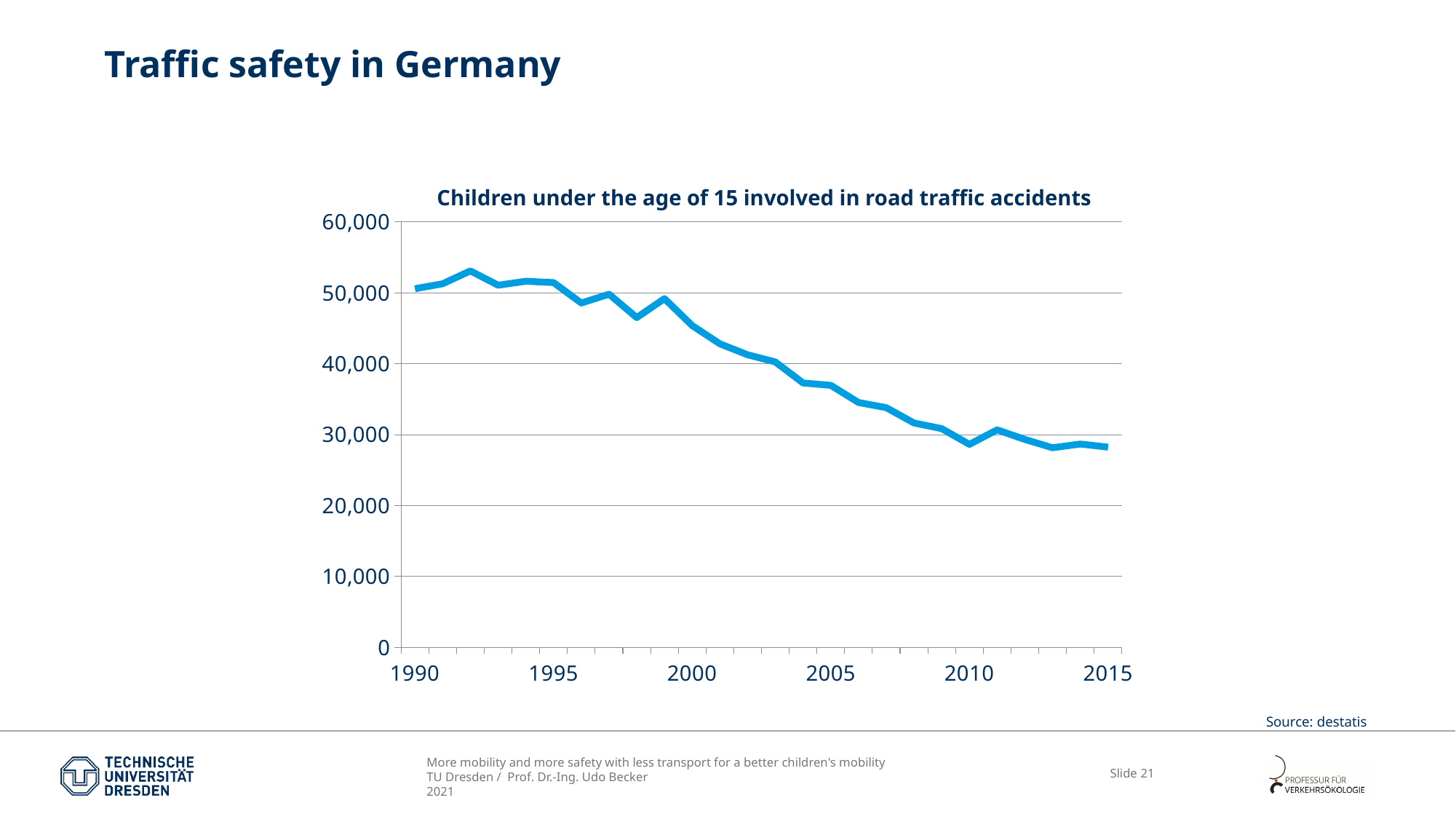
How many years are plotted on the chart, from 1990 to 2015 inclusive? 26 Is the value for 2008 greater or less than 30,000? greater Is the value for 2000 greater or less than 50,000? less Is the value for 2005 greater or less than 40,000? less What source is cited for the chart data? destatis Which year has the larger value, 1990 or 2015? 1990 In which year is the number of children involved in road traffic accidents highest? 1992 Overall, do the values rise or fall from 1990 to 2015? Fall What kind of chart is shown on the slide? Line chart What is the title of the chart? Children under the age of 15 involved in road traffic accidents